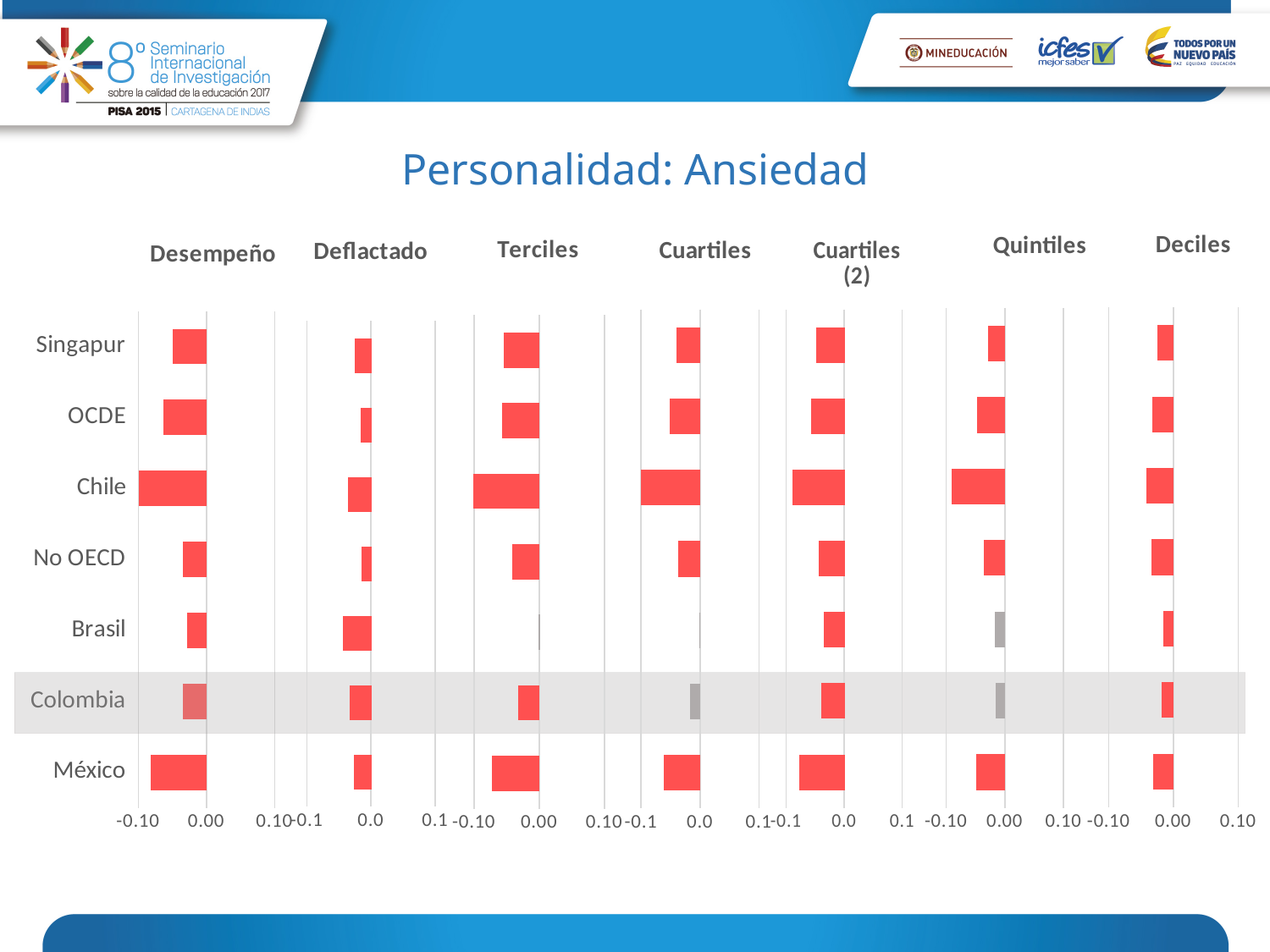
In the Quintiles chart, which has the longer bar, Chile or Brasil? Chile In the Desempeño chart, is the value for México greater or less than -0.10? greater In the Terciles chart, which category has the lowest (most negative) value? Chile What kind of chart is used on this slide? bar chart In the Cuartiles chart, is the value for Chile greater or less than 0.0? less How many countries or groups are listed on the vertical axis of the charts? 7 In the Terciles chart, which category has the value closest to zero? Brasil Which row of the charts is highlighted with a grey background band? Colombia How many separate panels (charts) are shown on the slide? 7 In the Desempeño chart, which has the longer bar, Chile or Singapur? Chile In the Desempeño chart, which category has the lowest (most negative) value? Chile What is the title of the slide's chart? Personalidad: Ansiedad